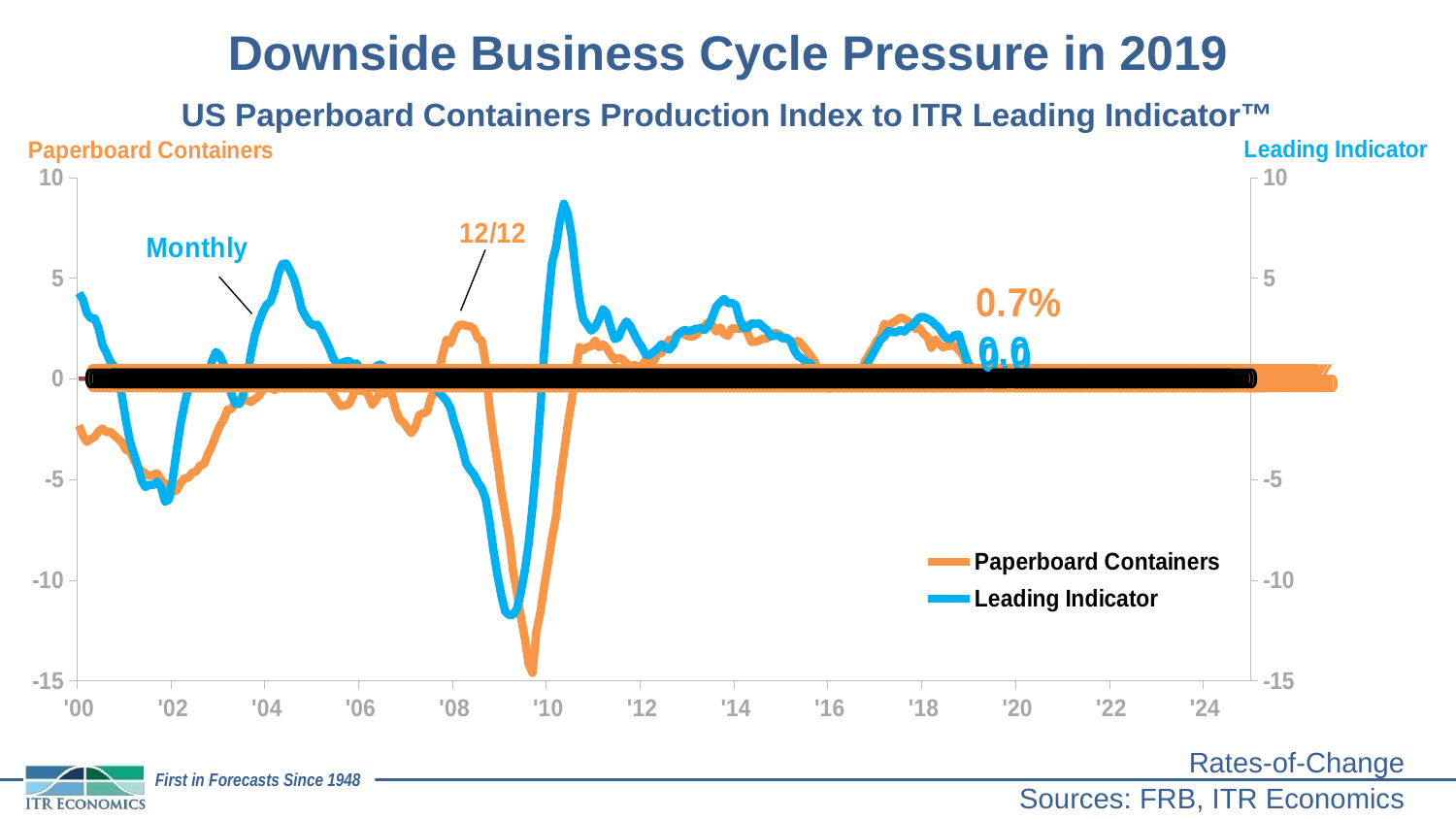
Is the lowest value of the Leading Indicator series around 2009 greater or less than -10? less Does the Paperboard Containers series rise or fall from 2017 to 2019? fall How many series does the legend list? 2 How many year labels are shown on the x axis? 13 Is the peak of the Paperboard Containers series around 2008 greater or less than 5? less What kind of chart is shown on the slide? line chart Which series reaches the lower minimum during the 2009-2010 downturn, Paperboard Containers or Leading Indicator? Paperboard Containers What is the title of the chart? US Paperboard Containers Production Index to ITR Leading Indicator™ Is the peak of the Leading Indicator series around 2010 greater or less than 5? greater What is the latest labeled value for the Paperboard Containers series? 0.7% Which series is labeled "Monthly" on the chart? Leading Indicator What is the maximum value shown on the left vertical axis? 10